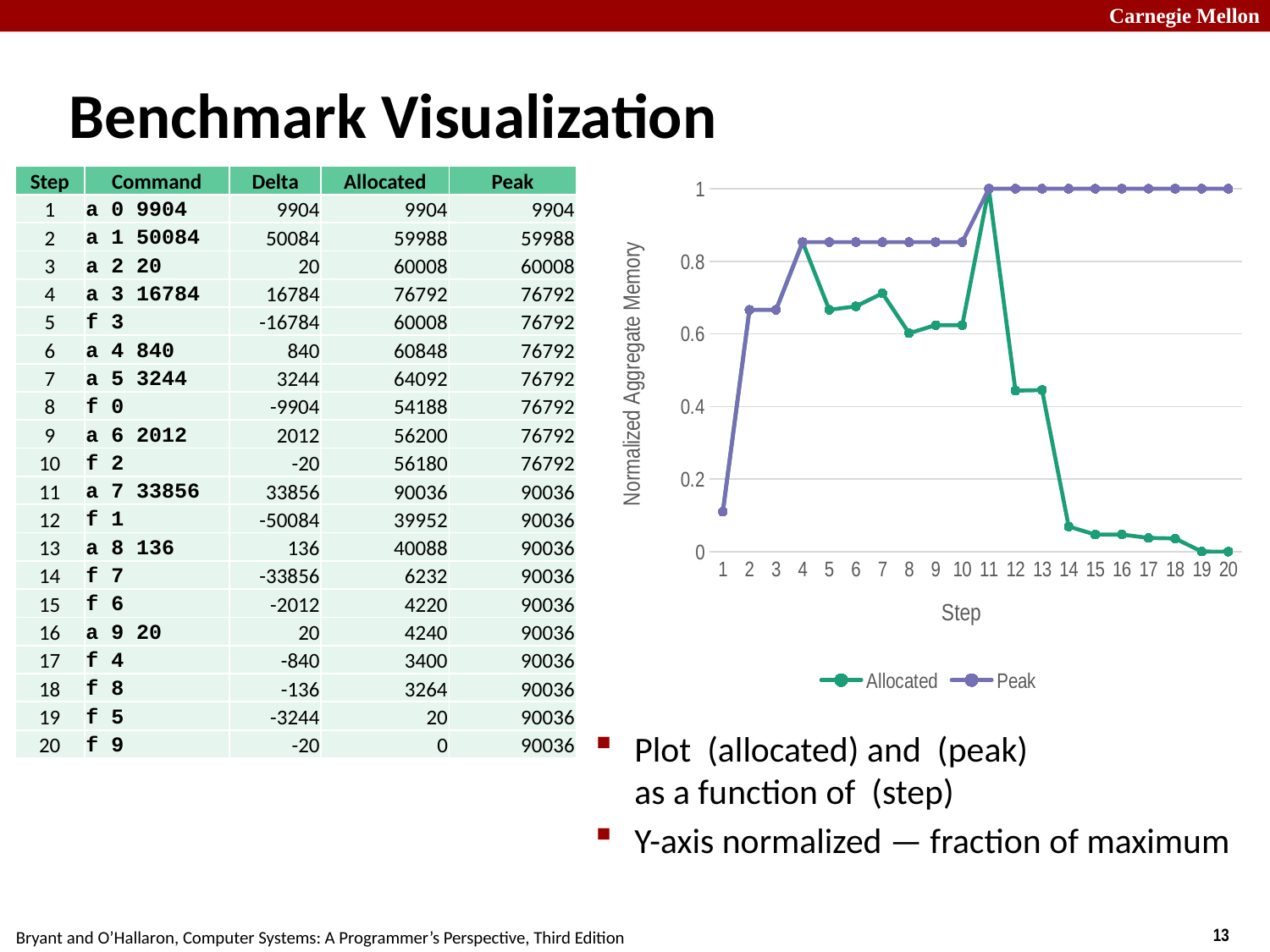
What is the Peak value at step 20 in the chart? 1 How many steps are plotted along the x axis of the chart? 20 Is the Allocated value at step 4 greater or less than 0.8? greater At step 12, which series has the larger value, Allocated or Peak? Peak What is the Allocated value at step 20 in the chart? 0 At which step does the Allocated series reach its highest value? 11 How many series does the chart's legend list? 2 Is the Allocated value at step 1 greater or less than 0.2? less What kind of chart is shown on the slide? line chart Does the Allocated series rise or fall from step 13 to step 20? fall What is the title of the chart's y axis? Normalized Aggregate Memory Is the Allocated value at step 12 greater or less than 0.6? less